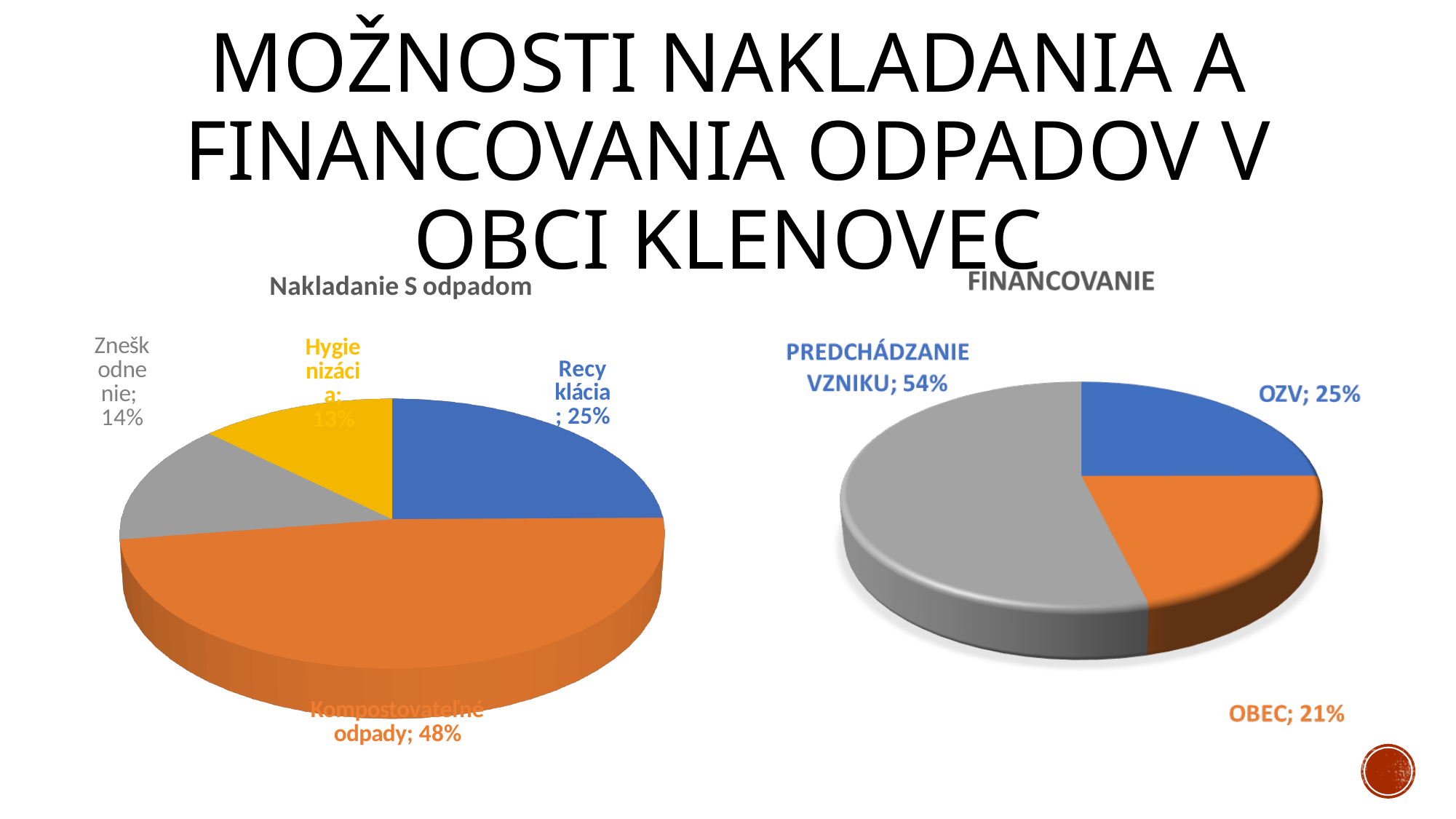
In the 'Nakladanie S odpadom' chart, what share is Recyklácia? 25% In the 'Nakladanie S odpadom' chart, what share is Zneškodnenie? 14% In the 'Nakladanie S odpadom' chart, what share is Kompostovateľné odpady? 48% In the 'Nakladanie S odpadom' chart, what is the difference between Kompostovateľné odpady and Recyklácia? 23% In the 'Nakladanie S odpadom' chart, which category has the smallest share? Hygienizácia In the 'FINANCOVANIE' chart, how many categories are shown? 3 In the 'Nakladanie S odpadom' chart, which category has the largest share? Kompostovateľné odpady What type of chart is the 'FINANCOVANIE' chart? Pie chart In the 'FINANCOVANIE' chart, which is larger, OZV or Obec? OZV In the 'FINANCOVANIE' chart, what share is Obec? 21% In the 'Nakladanie S odpadom' chart, how many categories are shown? 4 In the 'FINANCOVANIE' chart, what share is Predchádzanie vzniku? 54%